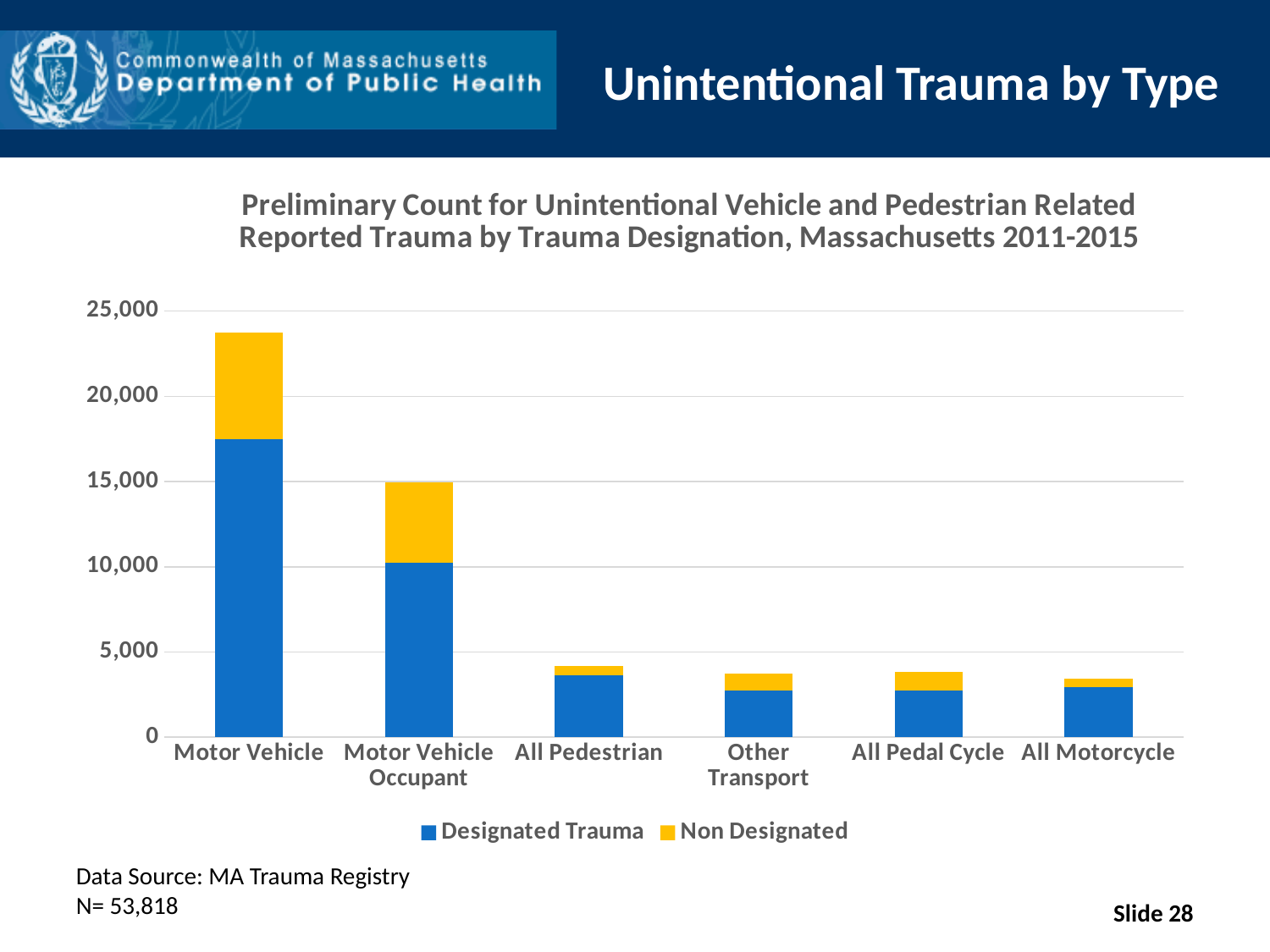
Which is larger, the total for Motor Vehicle or the total for Motor Vehicle Occupant? Motor Vehicle Is the Designated Trauma value for Motor Vehicle greater or less than 15,000? greater Is the total value for Motor Vehicle Occupant greater or less than 10,000? greater Is the total value for Motor Vehicle greater or less than 20,000? greater Which category has the highest total count? Motor Vehicle What data source is cited below the chart? MA Trauma Registry Which series is shown in yellow in the legend? Non Designated How many trauma type categories are shown on the x axis? 6 What kind of chart is shown on the slide? stacked bar chart How many series does the legend list? 2